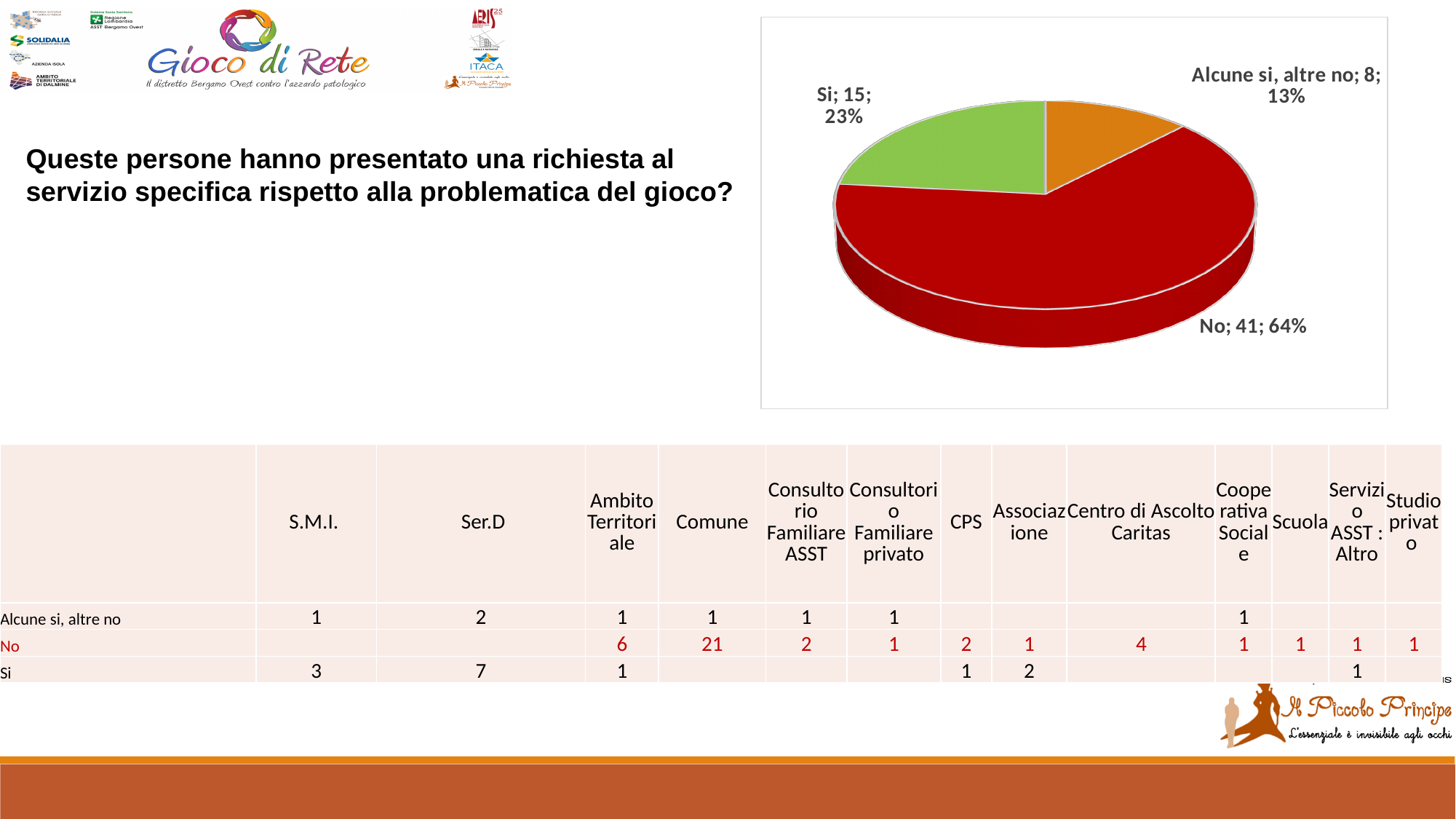
What share of the pie does the "Si" slice represent? 23% What is the value for the "No" slice of the pie chart? 41 How many slices does the pie chart have? 3 What is the difference between the "No" value and the "Si" value in the pie chart? 26 Which slice of the pie chart is the largest? No What is the value for the "Alcune si, altre no" slice of the pie chart? 8 Which slice of the pie chart is the smallest? Alcune si, altre no What share of the pie does the "Alcune si, altre no" slice represent? 13% What is the value for the "Si" slice of the pie chart? 15 What kind of chart is shown on the slide? pie chart Which slice is larger in the pie chart, "Si" or "Alcune si, altre no"? Si What share of the pie does the "No" slice represent? 64%